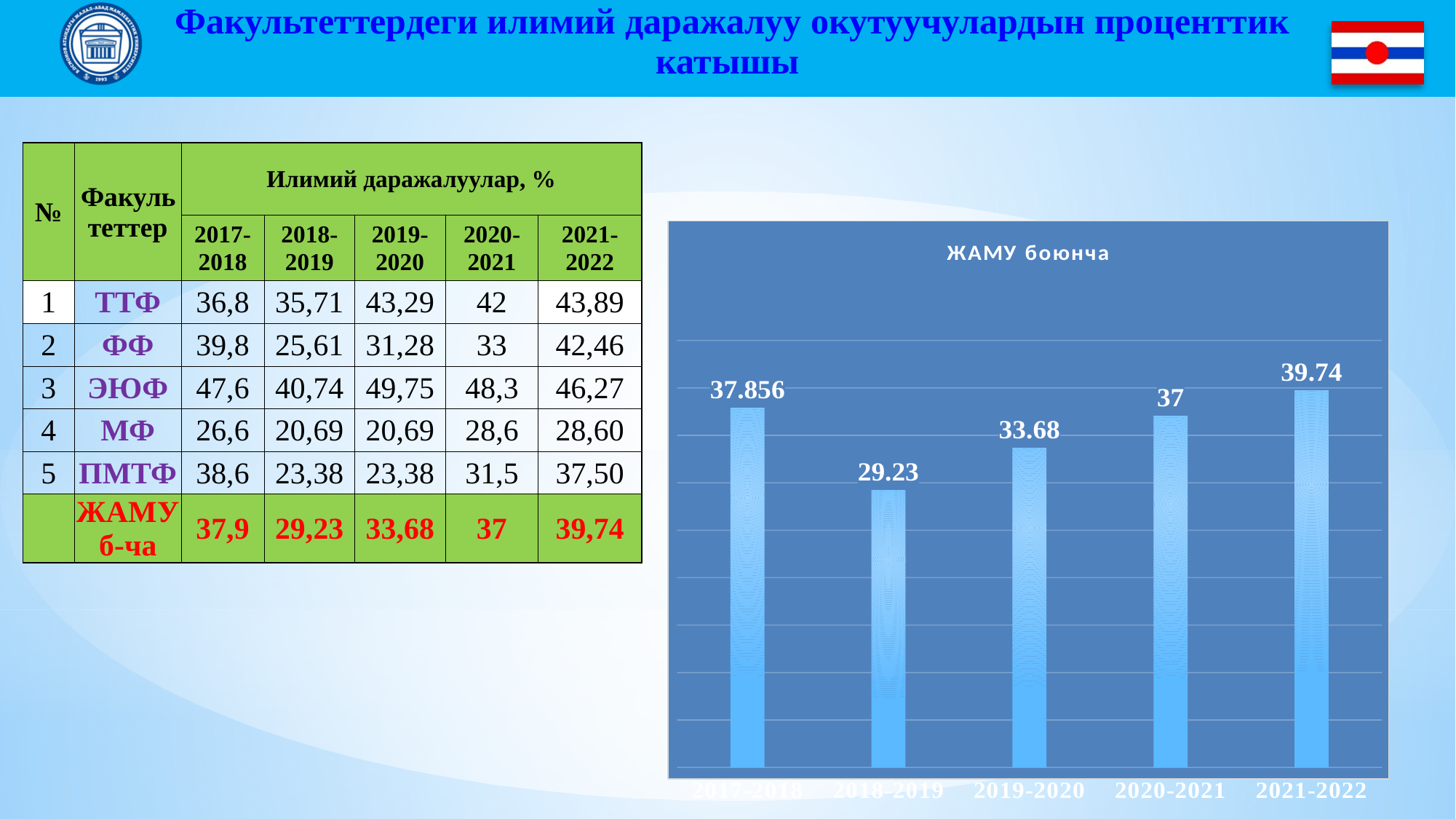
What kind of chart is shown on the slide? bar chart Which is larger, the value for 2019-2020 or the value for 2020-2021? 2020-2021 How many categories are shown on the x axis of the chart? 5 What is the value for 2018-2019 in the chart? 29.23 Which category has the highest value in the chart? 2021-2022 What is the value for 2021-2022 in the chart? 39.74 What is the value for 2017-2018 in the chart? 37.856 What is the value for 2019-2020 in the chart? 33.68 What is the difference between the values for 2021-2022 and 2018-2019? 10.51 What is the title of the chart? ЖАМУ боюнча What is the value for 2020-2021 in the chart? 37 Which category has the lowest value in the chart? 2018-2019